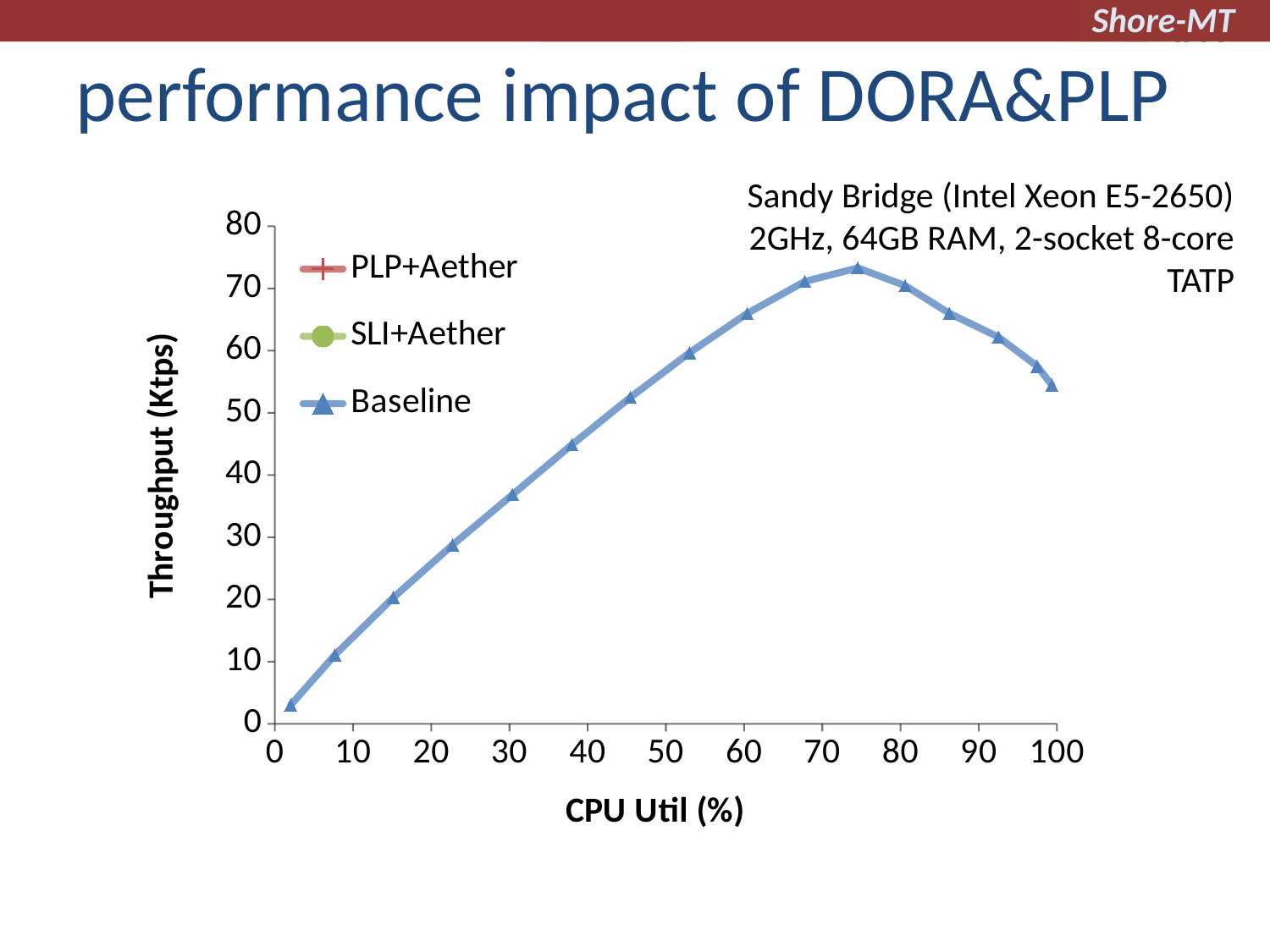
Is the Baseline throughput at about 30% CPU Util greater or less than 40 Ktps? less Is the Baseline throughput at the last plotted point (near 100% CPU Util) greater or less than 50 Ktps? greater Is the peak Baseline throughput greater or less than 70 Ktps? greater Does the Baseline throughput rise or fall as CPU Util increases from 0% to 70%? rise How many series does the legend list? 3 What kind of chart is shown on the slide? line chart Which series is actually plotted on the chart? Baseline What is the label of the y axis? Throughput (Ktps) Does the Baseline throughput rise or fall as CPU Util increases from 80% to 100%? fall Does the Baseline throughput reach its peak before or after 70% CPU Util? after